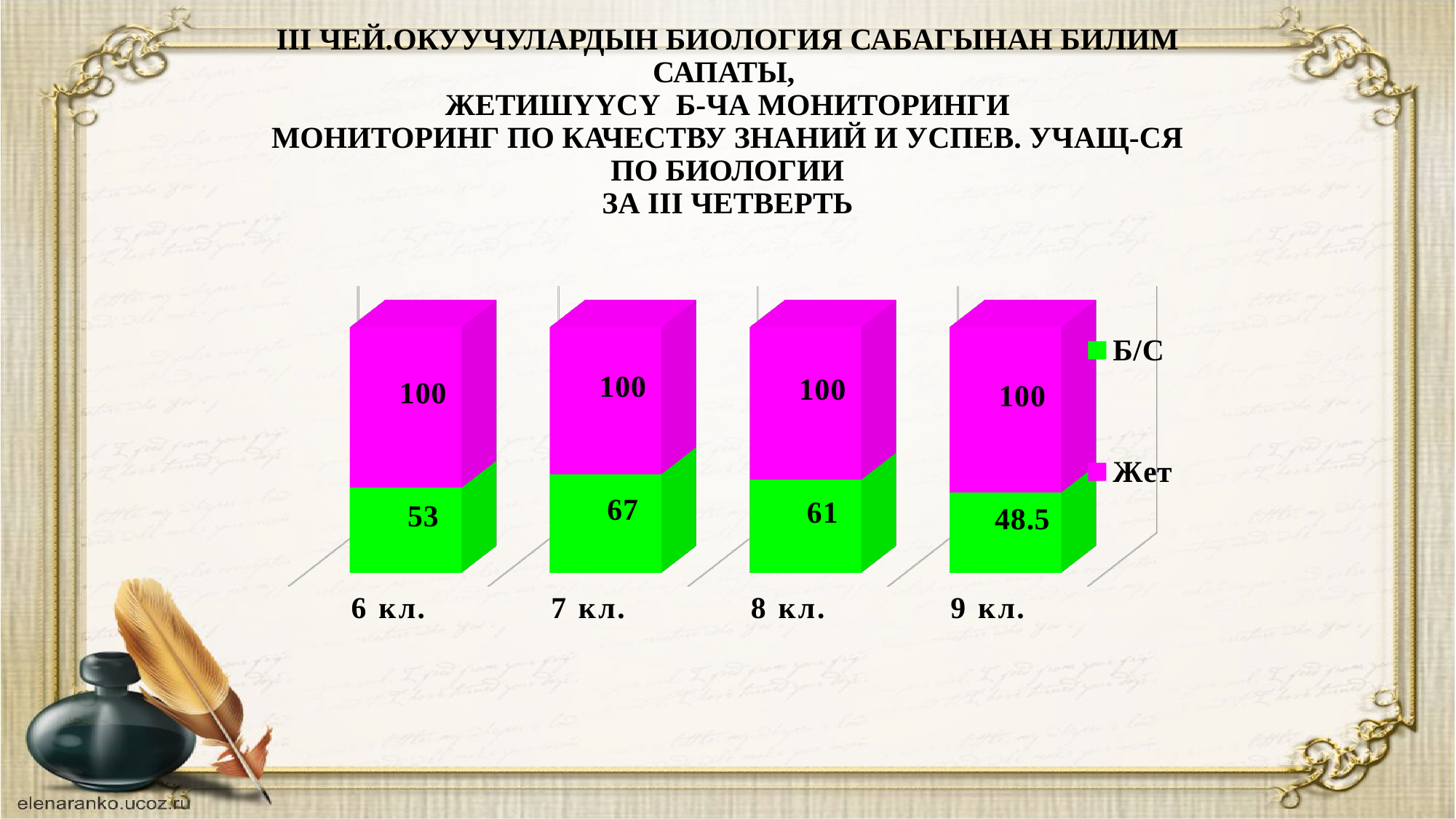
Which class has the highest Б/С value? 7 кл. What is the Жет value for 8 кл.? 100 Which colour represents the Жет series in the legend? Magenta Which class has the lowest Б/С value? 9 кл. How many classes are shown on the x axis? 4 What is the Б/С value for 9 кл.? 48.5 What kind of chart is shown on the slide? Stacked bar chart How many series does the legend list? 2 What is the difference between the Б/С values for 7 кл. and 6 кл.? 14 What is the Б/С value for 7 кл.? 67 Which is larger, the Б/С value for 8 кл. or for 9 кл.? 8 кл. What is the total of the stacked bar for 6 кл.? 153